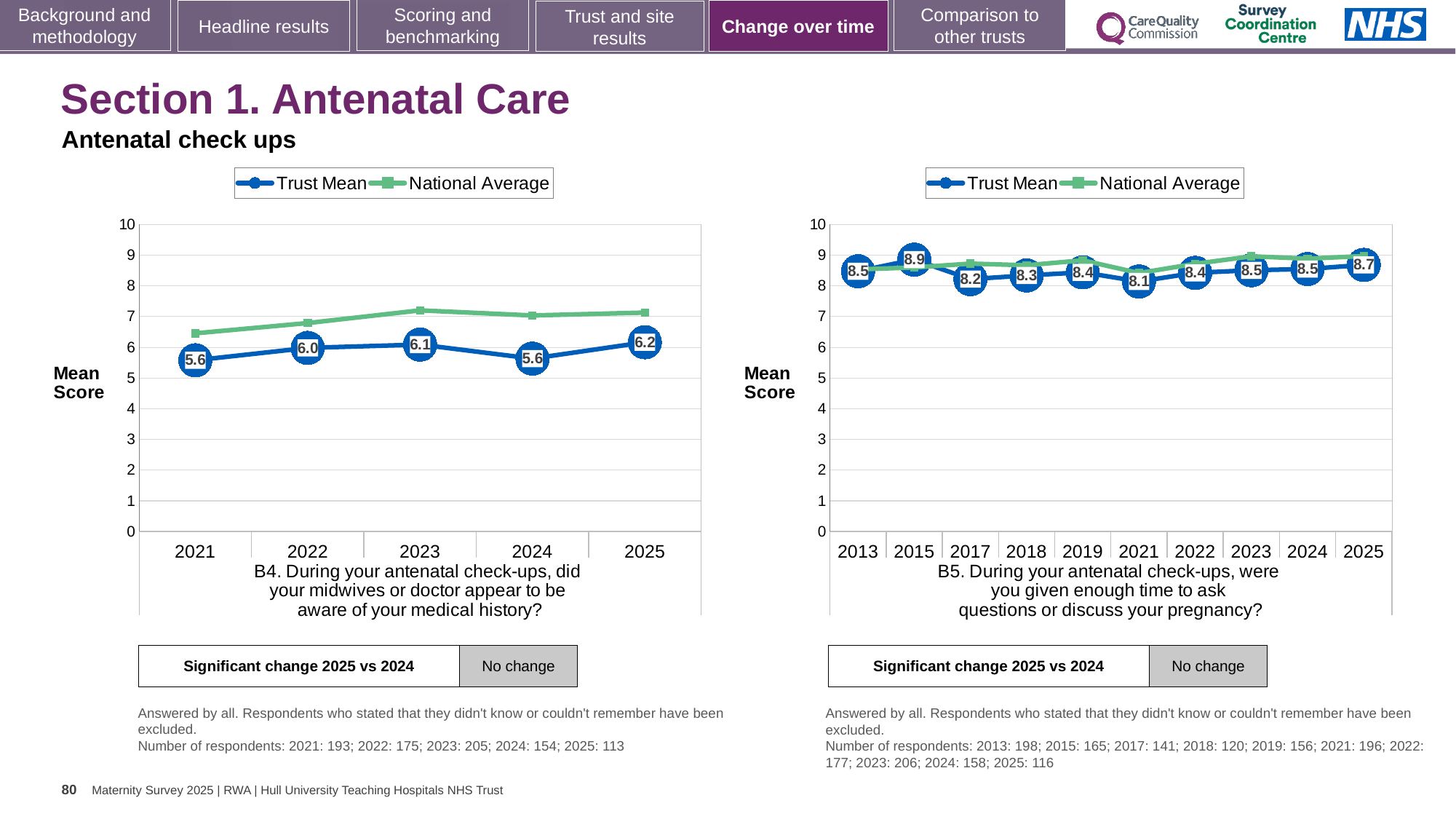
In the B4 chart on the left, what is the difference between the Trust Mean in 2023 and in 2024? 0.5 What type of chart is the B4 chart on the left? Line chart In the B4 chart on the left, what is the Trust Mean for 2021? 5.6 In the B5 chart on the right, what is the difference between the Trust Mean in 2015 and in 2021? 0.8 In the B5 chart on the right, is the Trust Mean higher in 2025 or in 2017? 2025 In the B5 chart on the right, how many series does the legend list? 2 In the B5 chart on the right, which year has the lowest Trust Mean? 2021 In the B4 chart on the left, how many years are shown on the x axis? 5 In the B4 chart on the left, which year has the highest Trust Mean? 2025 In the B4 chart on the left, what is the Trust Mean for 2025? 6.2 In the B5 chart on the right, what is the Trust Mean for 2015? 8.9 In the B4 chart on the left, is the National Average for 2023 greater or less than 7? greater